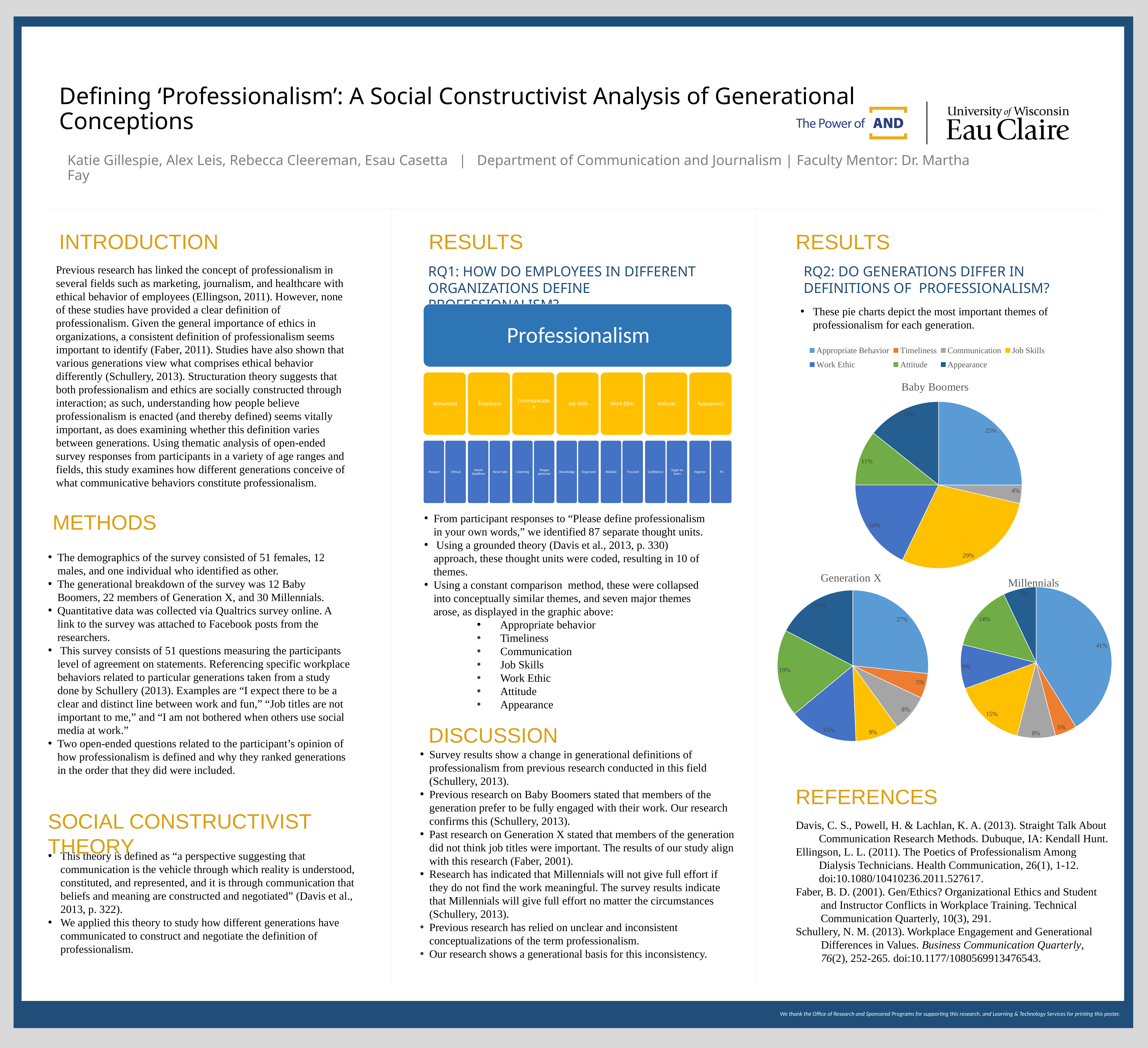
In the Baby Boomers pie chart, which theme has the largest share? Job Skills What type of chart is used to show the themes of professionalism for each generation? Pie chart In the Millennials pie chart, what share is Appearance? 7% In the Generation X pie chart, what share is Attitude? 19% In the Baby Boomers pie chart, which labeled theme has the smallest share? Communication In the Baby Boomers pie chart, what share is Appropriate Behavior? 25% In the Millennials pie chart, which is larger, Job Skills or Work Ethic? Job Skills In the Millennials pie chart, what share is Appropriate Behavior? 41% In the Generation X pie chart, what is the difference between the Appropriate Behavior share and the Timeliness share? 22% How many themes does the shared legend for the pie charts list? 7 In the Generation X pie chart, which theme has the largest share? Appropriate Behavior In the Baby Boomers pie chart, what share is Job Skills? 29%